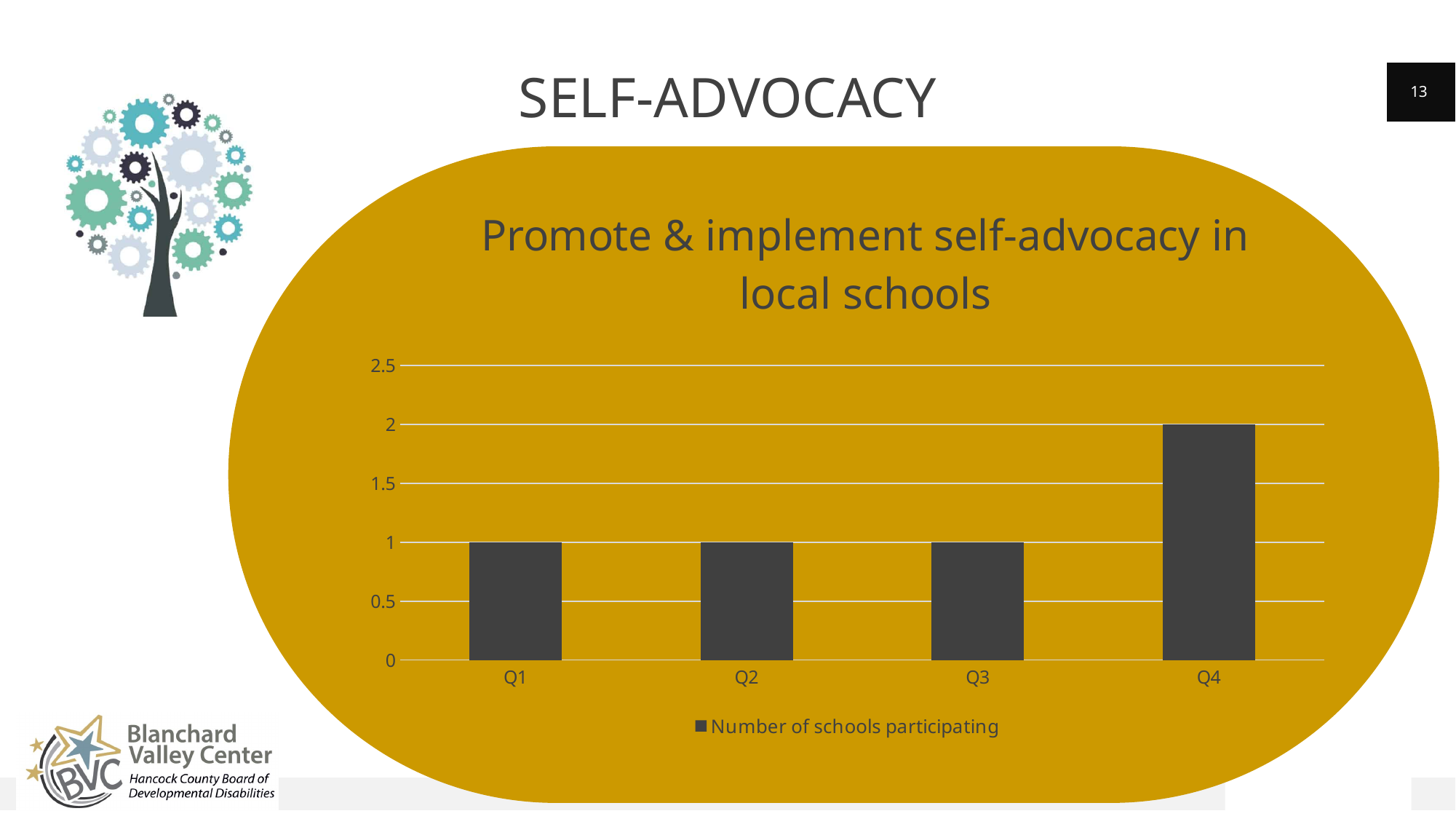
What is the difference between the number of schools participating in Q4 and Q1? 1 How many series does the chart legend list? 1 Which quarter has the highest number of schools participating? Q4 How many quarters are shown on the x axis of the chart? 4 Is the value for Q2 greater or less than 1.5? less What is the number of schools participating in Q3? 1 What is the number of schools participating in Q4? 2 What is the series name shown in the chart legend? Number of schools participating Which is larger, the value for Q2 or the value for Q4? Q4 What is the number of schools participating in Q1? 1 What kind of chart is shown on the slide? Bar chart Is the value for Q4 greater or less than 1.5? greater